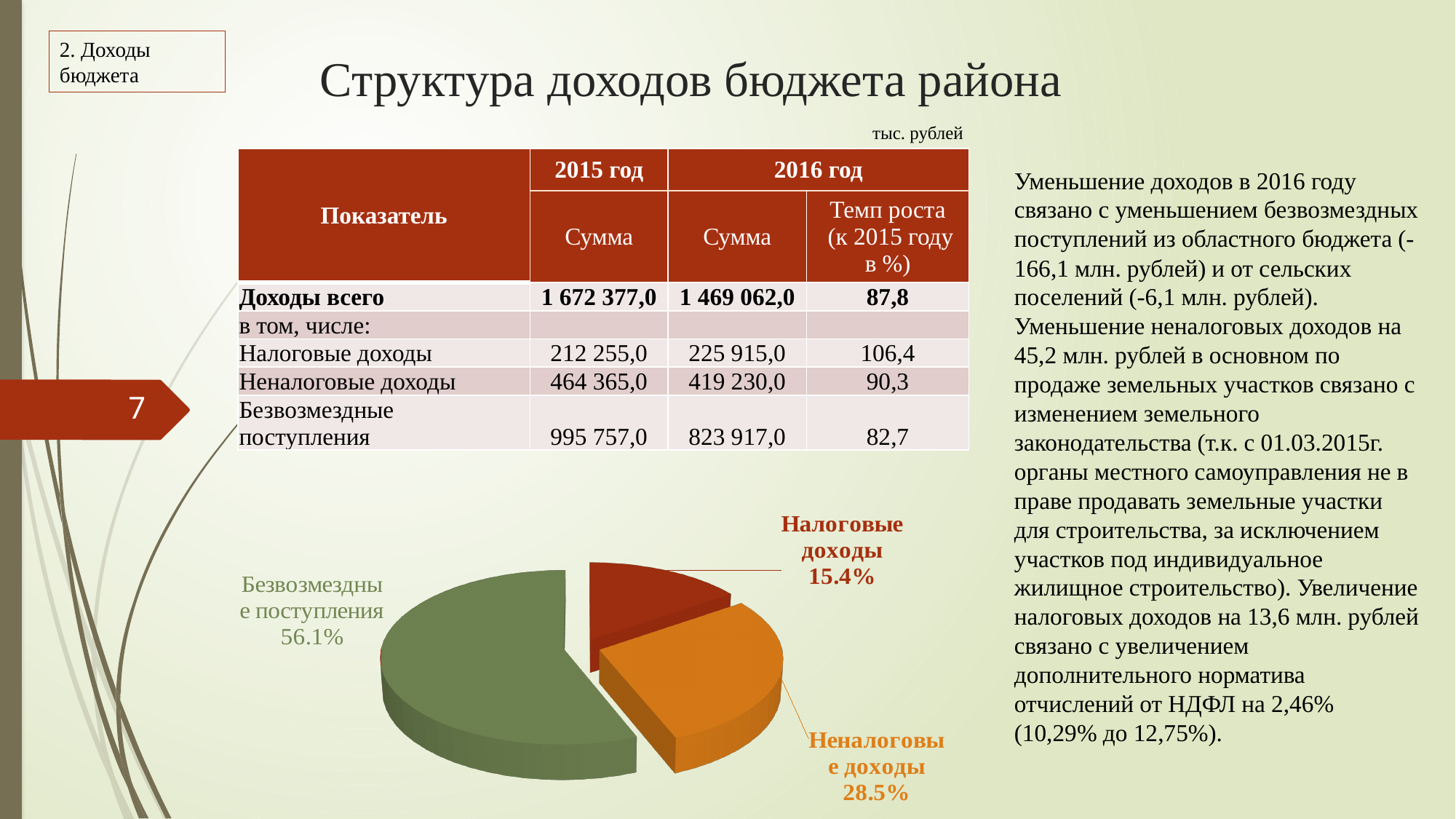
What is the value shown for Неналоговые доходы in the pie chart? 28.5% Which slice of the pie chart is the largest? Безвозмездные поступления Which slice of the pie chart is the smallest? Налоговые доходы What share of the pie does Безвозмездные поступления take? 56.1% Is the share for Безвозмездные поступления greater or less than 50%? greater What kind of chart is shown on the slide? Pie chart What colour is the Неналоговые доходы slice in the pie chart? Orange Which is larger in the pie chart: Неналоговые доходы or Налоговые доходы? Неналоговые доходы What is the difference in percentage points between Безвозмездные поступления and Неналоговые доходы in the pie chart? 27.6 What is the value shown for Налоговые доходы in the pie chart? 15.4% How many slices does the pie chart have? 3 What is the difference in percentage points between Неналоговые доходы and Налоговые доходы in the pie chart? 13.1